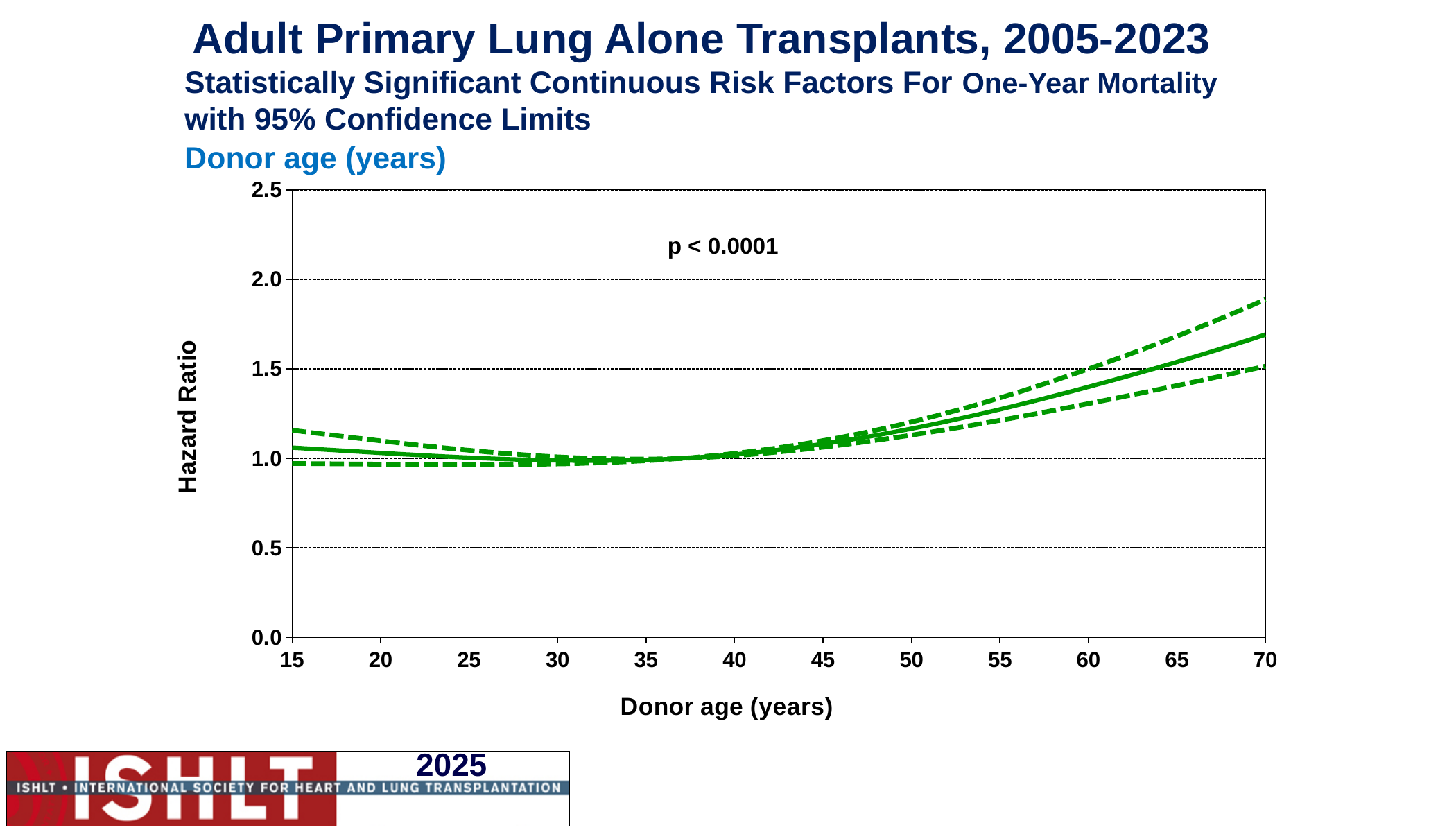
Does the hazard ratio of the solid line rise or fall as donor age increases from 40 to 70? rise Which donor age has the higher hazard ratio on the solid line, 35 or 65? 65 Is the hazard ratio of the solid line at donor age 70 greater or less than 1.5? greater Is the hazard ratio of the upper dashed confidence limit at donor age 70 greater or less than 2.0? less Is the hazard ratio of the lower dashed confidence limit at donor age 70 greater or less than 1.0? greater What is the label of the y axis? Hazard Ratio What p-value is printed on the chart? p < 0.0001 How many lines are plotted on the chart? 3 What kind of chart is shown on the slide? line chart What is the title of the chart's risk factor shown in blue above the plot? Donor age (years)